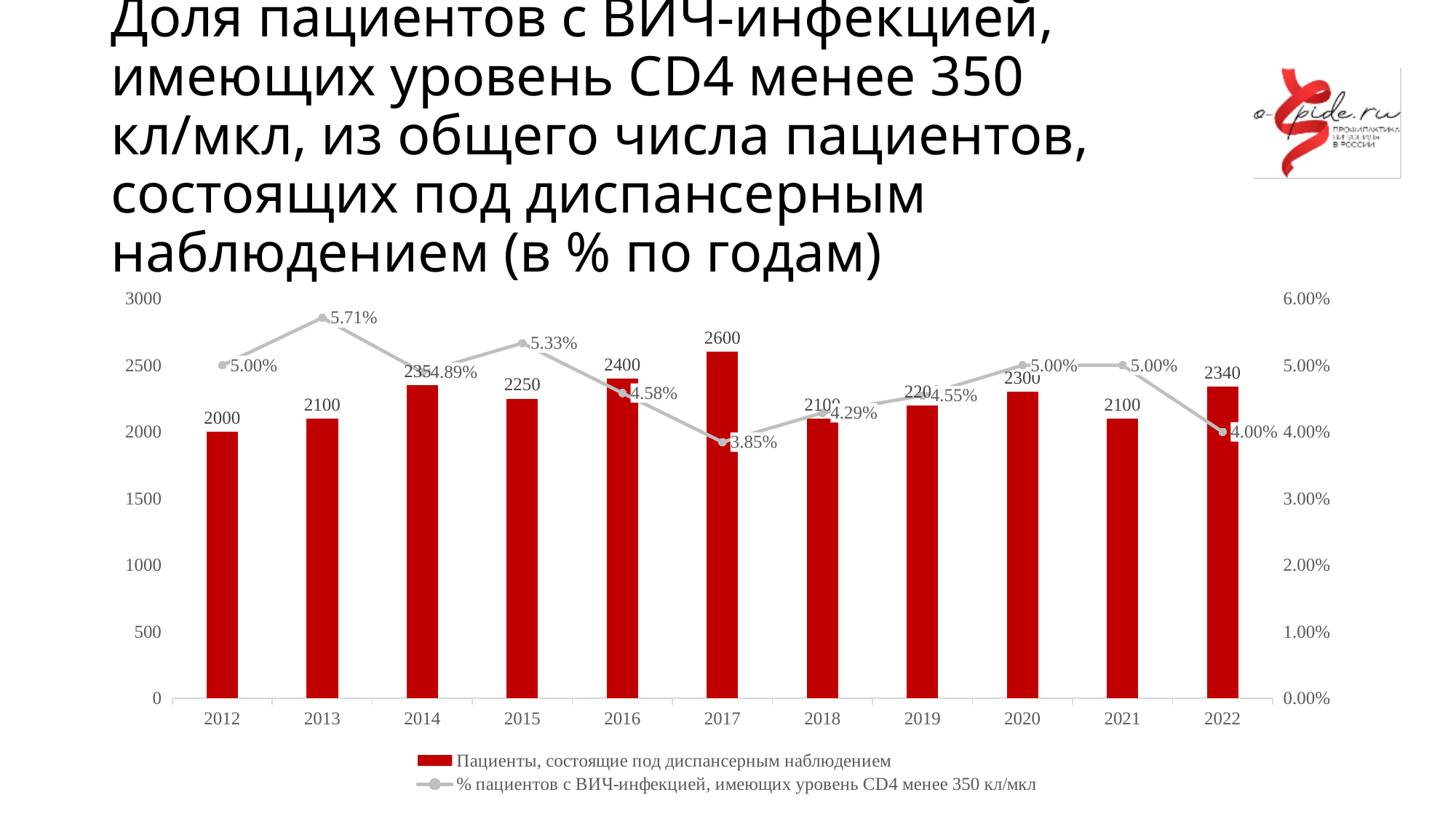
What colour are the bars for patients under dispensary observation? Red What is the value of the bar for 2022? 2340 What percentage is shown on the line for 2017? 3.85% What is the difference between the number of patients in 2017 and in 2012? 600 How many years are shown on the x axis? 11 What percentage of patients had a CD4 level below 350 cells/µl in 2013? 5.71% What is the value of the bar for 2017 (patients under dispensary observation)? 2600 How many series does the legend list? 2 Which year has the lowest percentage of patients with CD4 below 350 cells/µl? 2017 Which is larger: the number of patients in 2016 or in 2021? 2016 Which year has the highest number of patients under dispensary observation? 2017 Which year has the highest percentage of patients with CD4 below 350 cells/µl? 2013